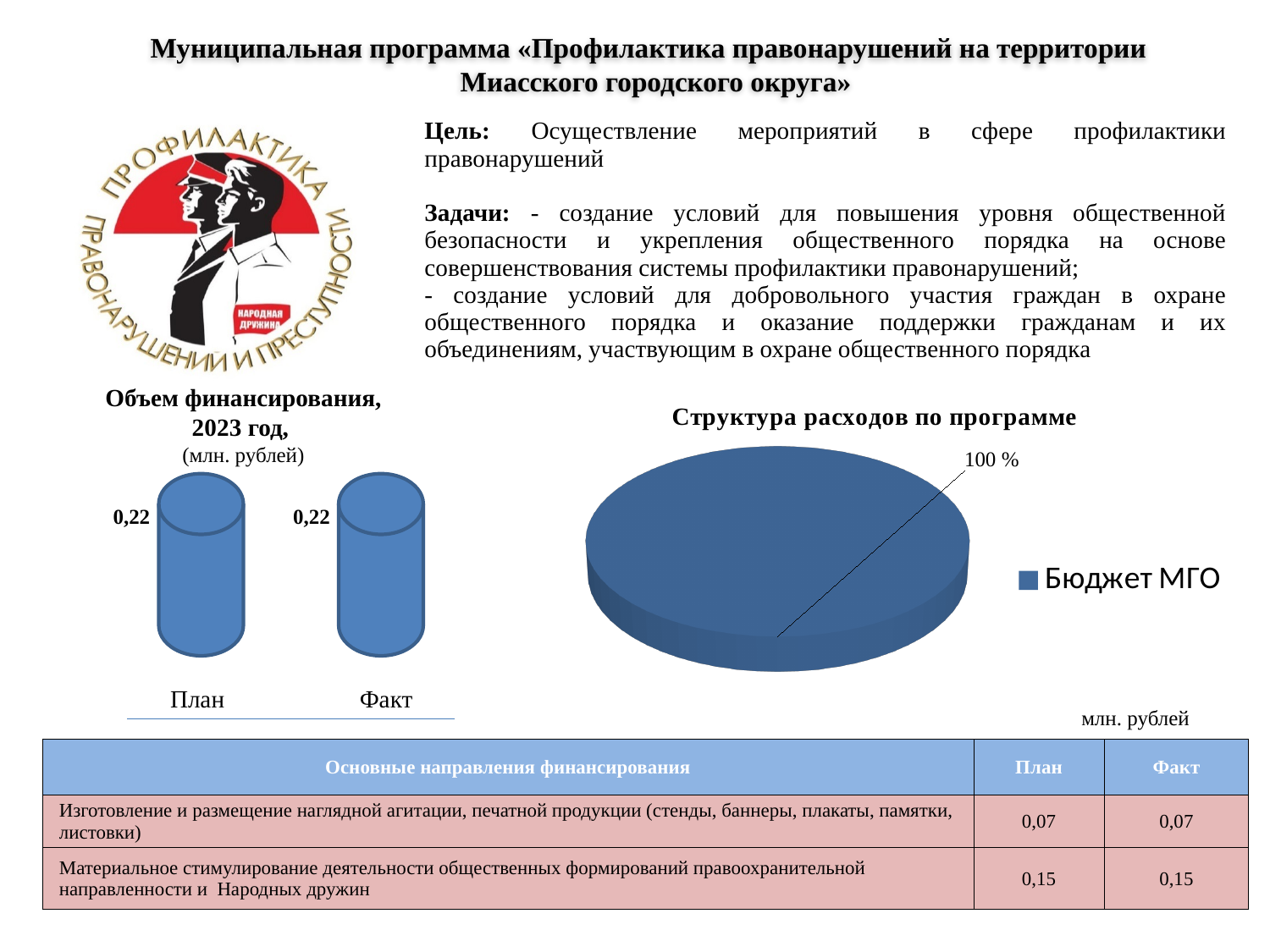
What kind of chart is "Структура расходов по программе"? Pie chart In the chart "Объем финансирования, 2023 год", what unit is stated under the title? млн. рублей In the chart "Объем финансирования, 2023 год", what is the difference between the План and Факт values? 0 In the chart "Структура расходов по программе", how many entries does the legend list? 1 In the chart "Структура расходов по программе", what share does the Бюджет МГО slice have? 100 % In the chart "Структура расходов по программе", what is the name of the only legend entry? Бюджет МГО In the chart "Структура расходов по программе", how many slices does the pie have? 1 In the chart "Объем финансирования, 2023 год", what is the value for План? 0,22 What kind of chart is "Объем финансирования, 2023 год"? Bar chart In the chart "Объем финансирования, 2023 год", how many bars are plotted? 2 In the chart "Объем финансирования, 2023 год", what is the value for Факт? 0,22